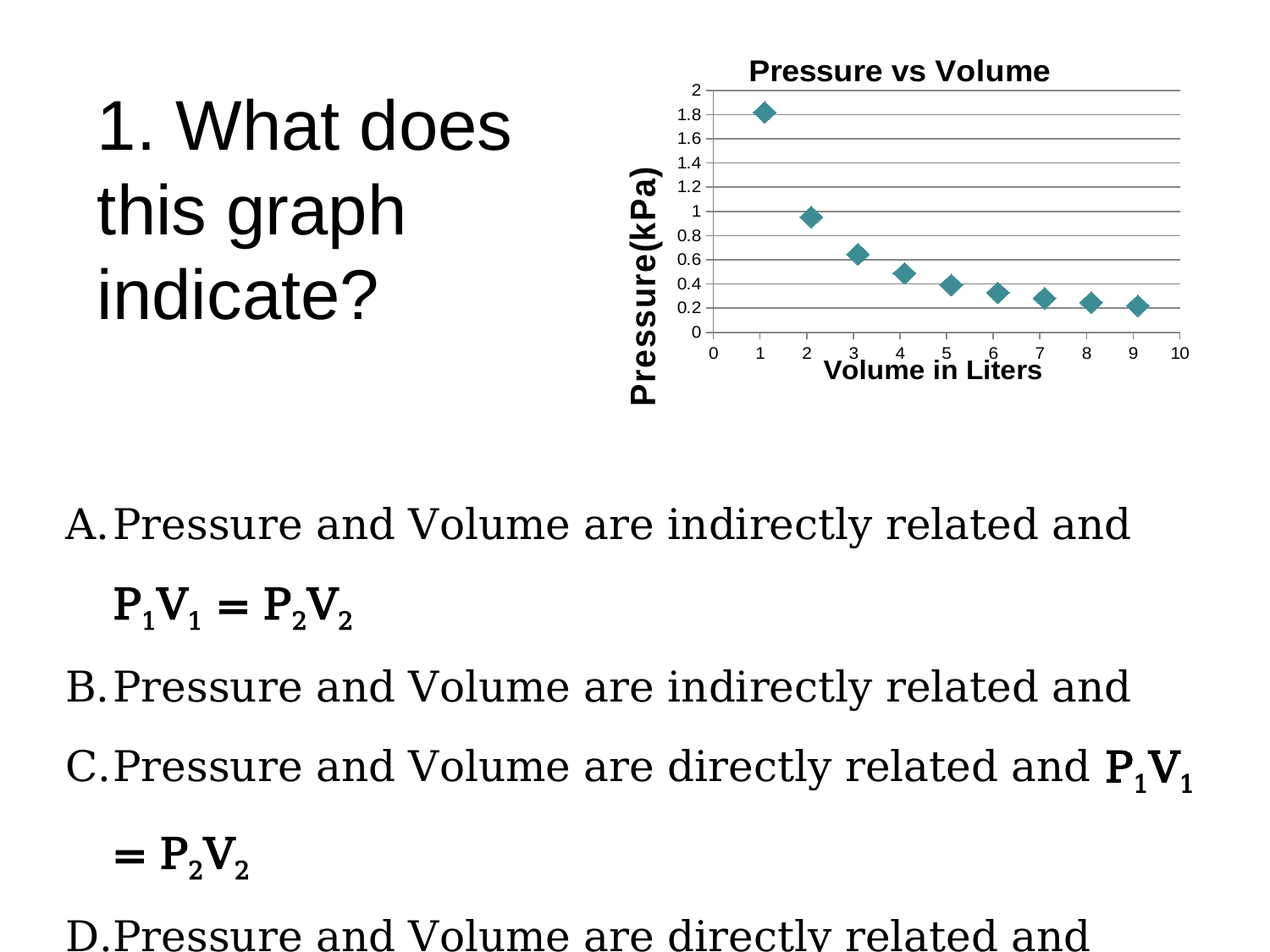
How many data points are plotted on the chart? 9 What is the title of the chart? Pressure vs Volume Is the pressure at a volume of 2 liters greater or less than 1? less Is the pressure at a volume of 3 liters greater or less than 0.6? greater As volume increases along the x axis, does pressure rise or fall? fall What is the label of the vertical axis of the chart? Pressure(kPa) Is the pressure at a volume of 1 liter greater or less than 1.6? greater What kind of chart is shown on the slide? scatter plot Which has the higher pressure: the point at 2 liters or the point at 5 liters? 2 liters